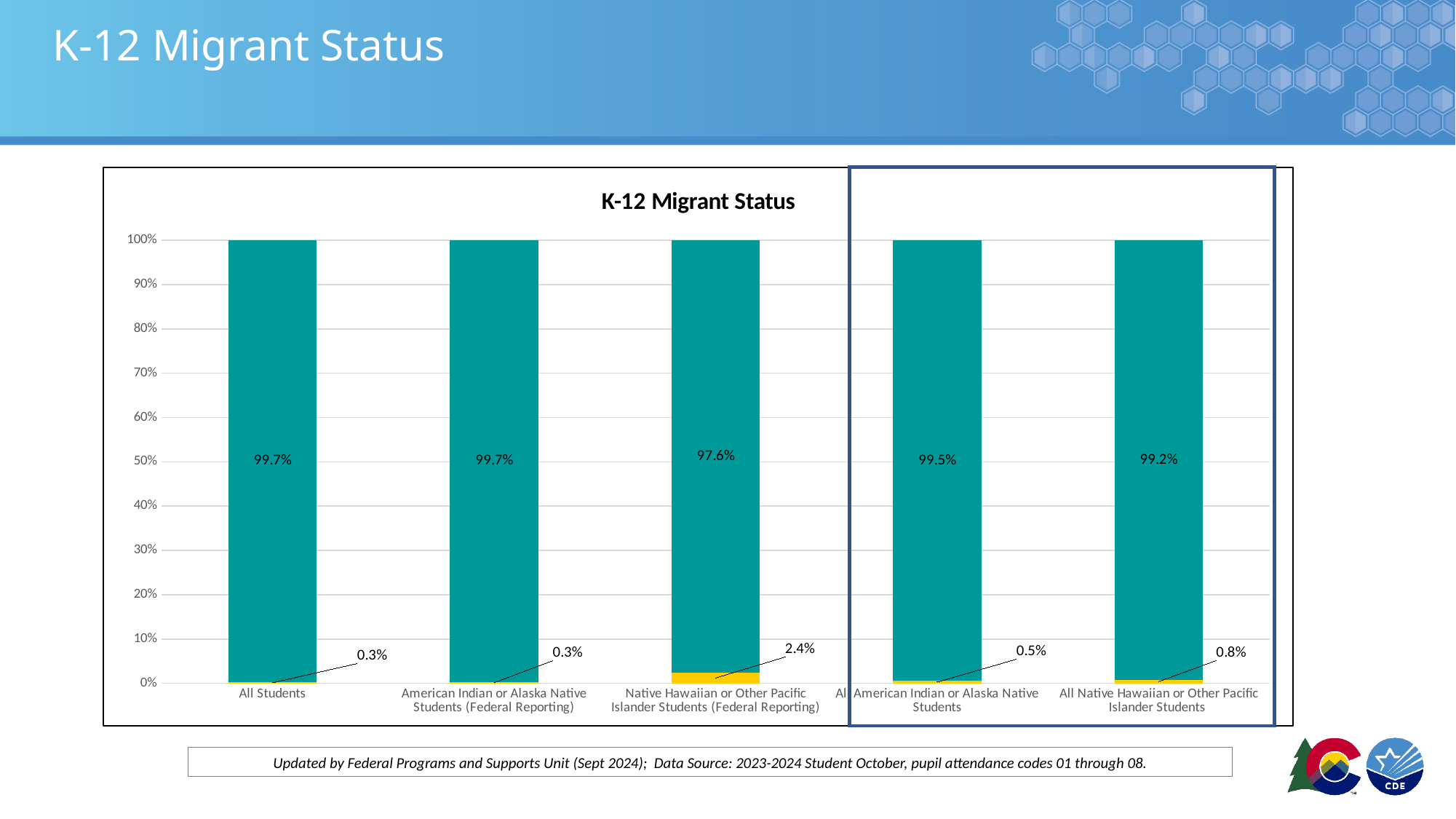
What type of chart is shown on the slide? stacked bar chart Which category has the highest yellow segment value? Native Hawaiian or Other Pacific Islander Students (Federal Reporting) Which category has the lowest teal segment value? Native Hawaiian or Other Pacific Islander Students (Federal Reporting) What is the title of the chart? K-12 Migrant Status What is the value of the teal segment for All American Indian or Alaska Native Students? 99.5% What is the value of the teal segment for Native Hawaiian or Other Pacific Islander Students (Federal Reporting)? 97.6% Which has a larger yellow segment value: All American Indian or Alaska Native Students or All Native Hawaiian or Other Pacific Islander Students? All Native Hawaiian or Other Pacific Islander Students What is the value of the yellow segment for All Native Hawaiian or Other Pacific Islander Students? 0.8% What is the difference between the yellow segment values for Native Hawaiian or Other Pacific Islander Students (Federal Reporting) and All Students? 2.1% What is the value of the yellow segment for All Students? 0.3% How many categories are shown on the x axis of the chart? 5 What is the total of the stacked bar for All Native Hawaiian or Other Pacific Islander Students? 100%